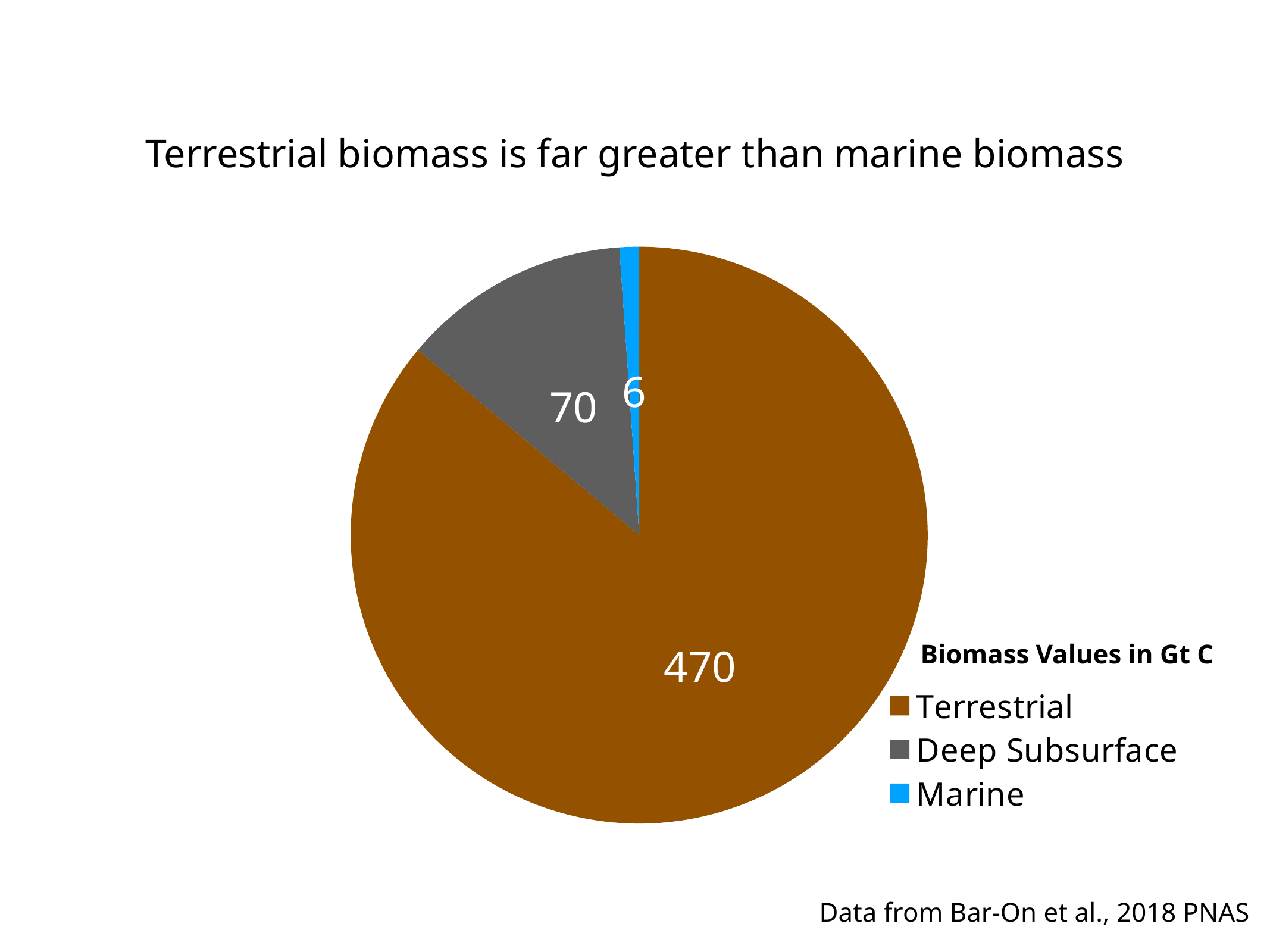
What is the biomass value for Deep Subsurface? 70 Which category has the largest slice of the pie? Terrestrial Which category has the smallest slice of the pie? Marine How many slices does the pie chart have? 3 What kind of chart is shown on the slide? Pie chart What is the legend title of the chart? Biomass Values in Gt C What is the difference between the Deep Subsurface and Marine values? 64 What is the total of all three slices? 546 Which is larger, Deep Subsurface or Marine? Deep Subsurface What is the difference between the Terrestrial and Deep Subsurface values? 400 What is the biomass value for Terrestrial? 470 What is the biomass value for Marine? 6